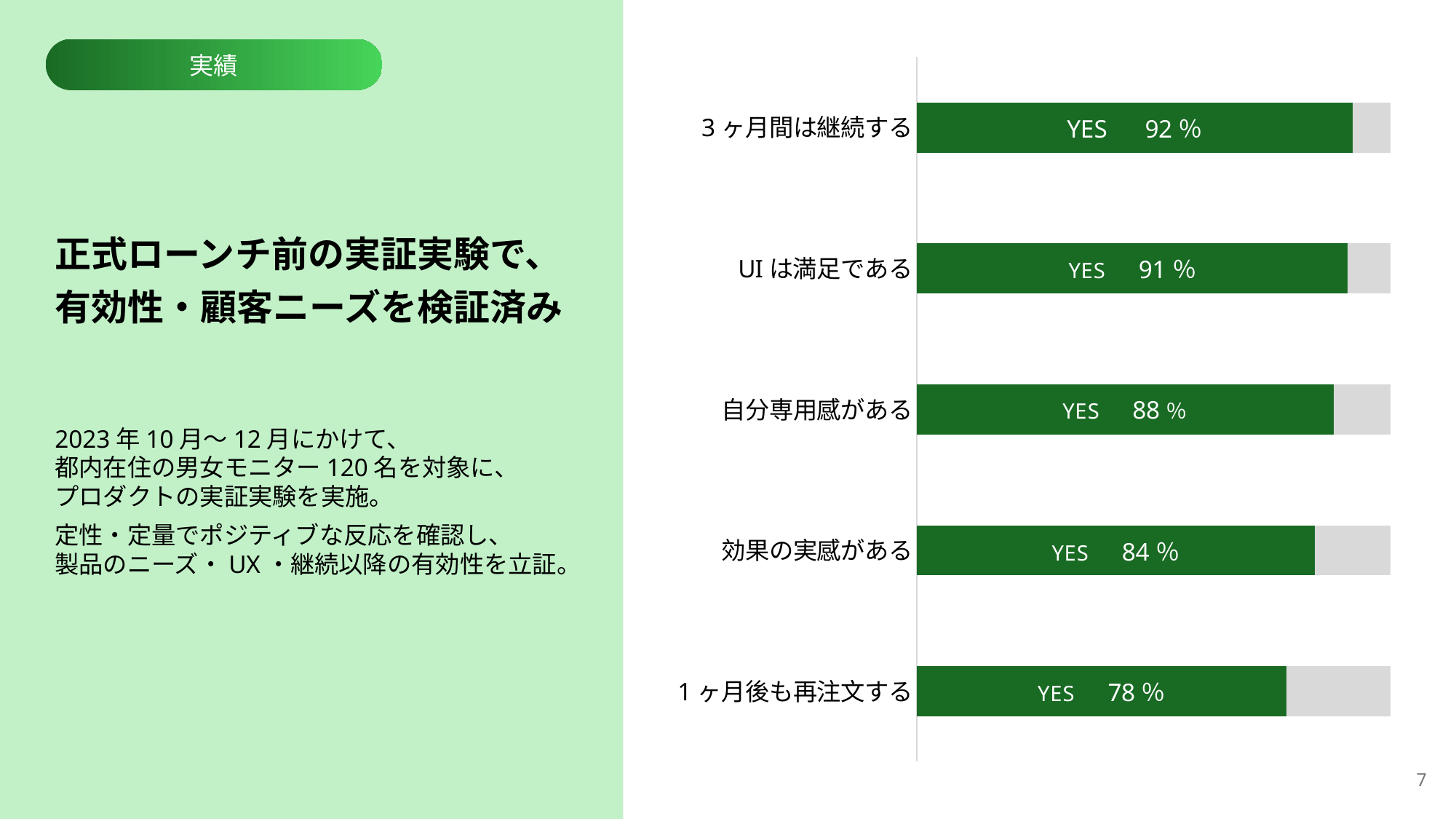
What is the difference between the YES values for 3ヶ月間は継続する and 1ヶ月後も再注文する? 14 % What kind of chart is shown on the slide? Bar chart What is the YES value for UIは満足である? 91 % What is the YES value for 自分専用感がある? 88 % Which has a larger YES value, 効果の実感がある or 1ヶ月後も再注文する? 効果の実感がある Which category has the highest YES value? 3ヶ月間は継続する What is the YES value for 効果の実感がある? 84 % What is the YES value for 1ヶ月後も再注文する? 78 % What is the difference between the YES values for 自分専用感がある and 効果の実感がある? 4 % How many categories are shown in the chart? 5 What is the YES value for 3ヶ月間は継続する? 92 % Which category has the lowest YES value? 1ヶ月後も再注文する